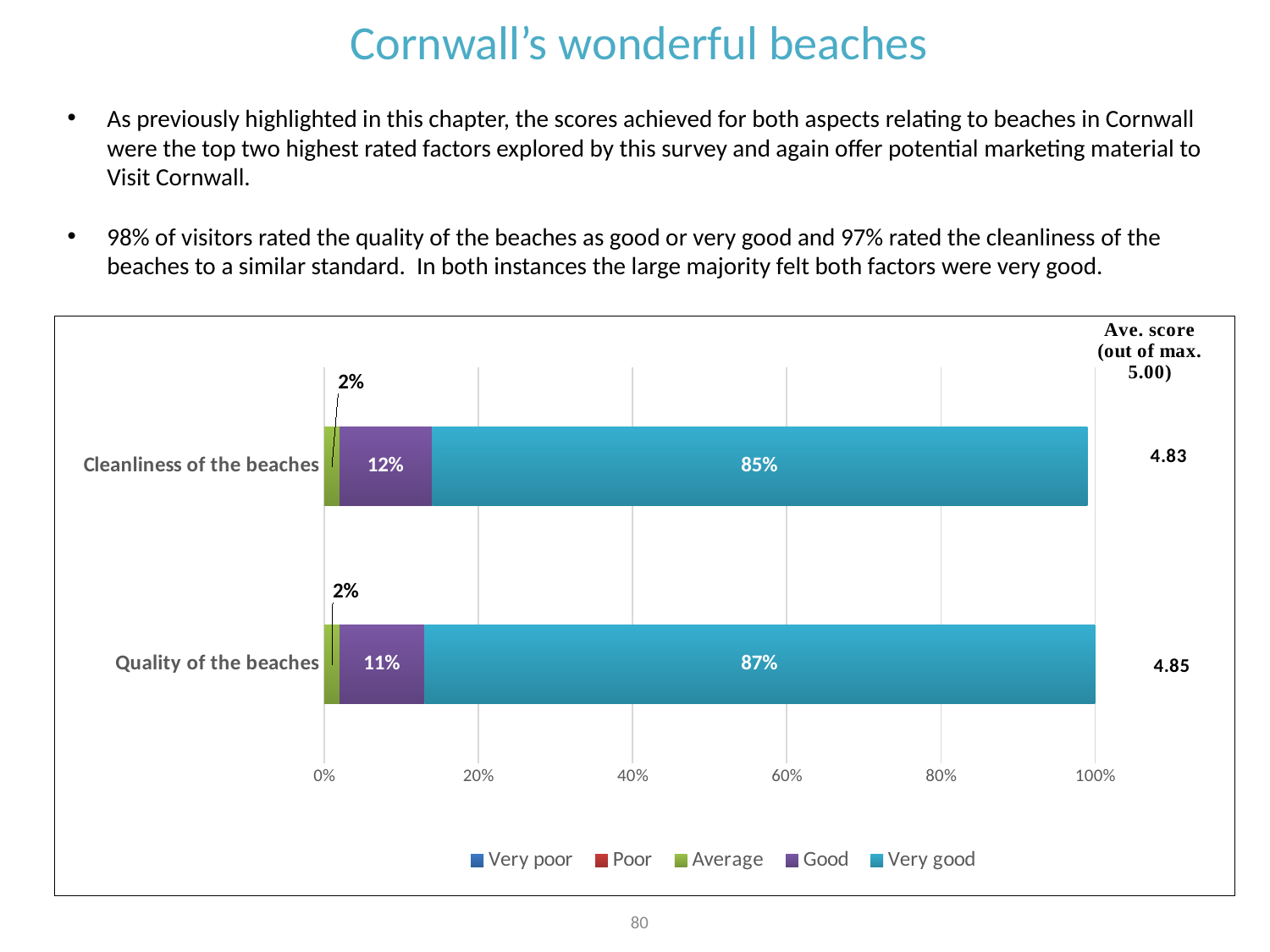
What kind of chart is shown on the slide? Stacked bar chart What percentage of visitors rated the cleanliness of the beaches as very good? 85% What percentage of visitors rated the quality of the beaches as good? 11% How many categories are shown on the chart? 2 What is the average score (out of 5.00) shown for the cleanliness of the beaches? 4.83 What is the average score (out of 5.00) shown for the quality of the beaches? 4.85 What percentage of visitors rated the cleanliness of the beaches as average? 2% How many series does the legend list? 5 What is the difference between the 'Very good' percentages for quality of the beaches and cleanliness of the beaches? 2% What percentage of visitors rated the cleanliness of the beaches as good? 12% Which category has the higher 'Very good' percentage, cleanliness of the beaches or quality of the beaches? Quality of the beaches What percentage of visitors rated the quality of the beaches as very good? 87%